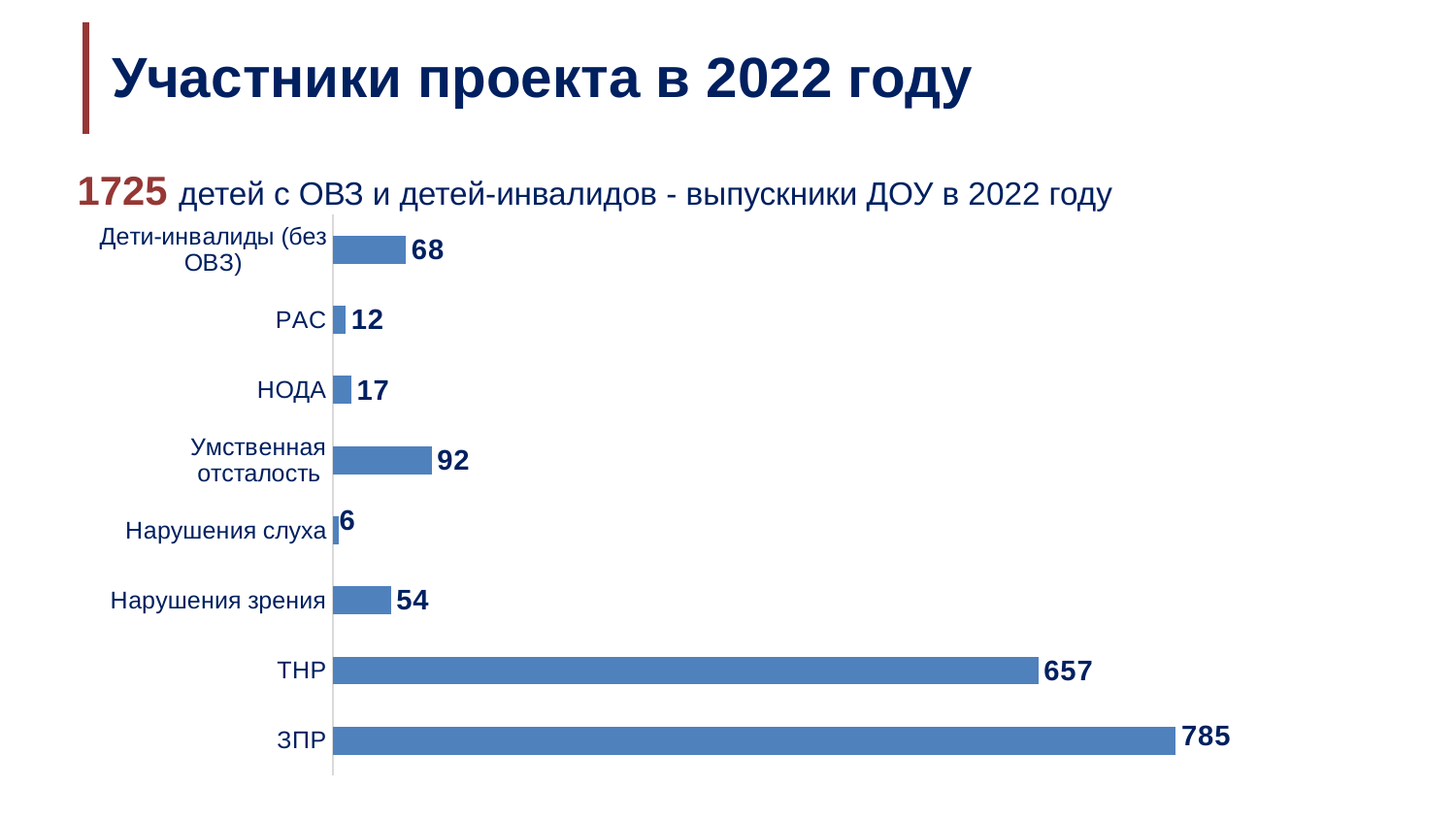
What is the value for ТНР? 657 What is the difference between the values for Умственная отсталость and Нарушения зрения? 38 Which category has the highest value? ЗПР How many categories are shown in the chart? 8 What is the value for Дети-инвалиды (без ОВЗ)? 68 What is the difference between the values for ЗПР and ТНР? 128 What is the value for ЗПР? 785 Which category has the lowest value? Нарушения слуха What kind of chart is shown on the slide? Bar chart Which is larger, the value for НОДА or the value for РАС? НОДА What total number of children is stated in the text above the chart? 1725 What is the value for Умственная отсталость? 92